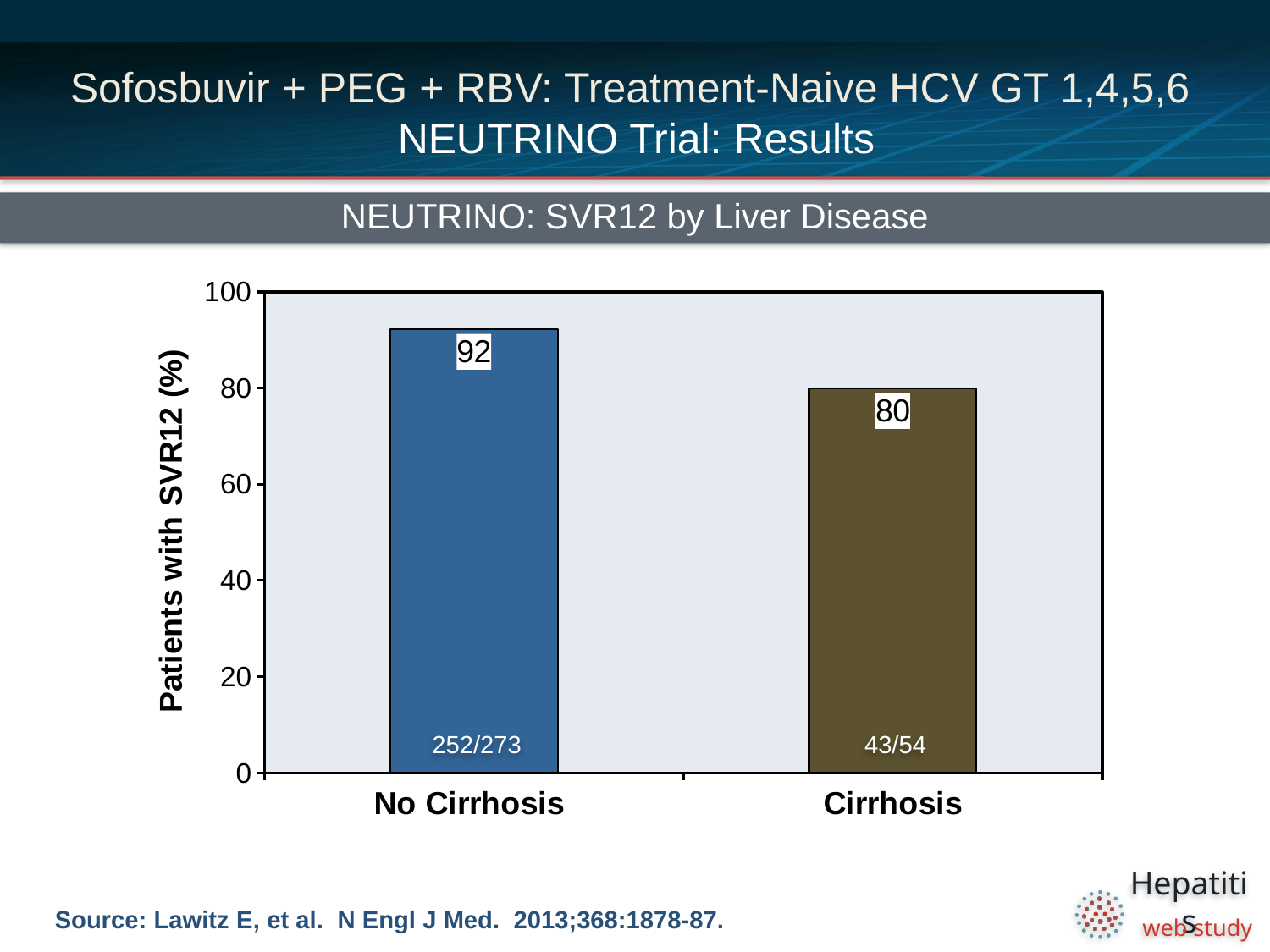
What is the difference in SVR12 rate between the No Cirrhosis and Cirrhosis groups? 12 What fraction of patients is printed inside the No Cirrhosis bar? 252/273 What is the SVR12 rate for the Cirrhosis group? 80 Which group has the higher SVR12 rate? No Cirrhosis Which group has the lower SVR12 rate? Cirrhosis What is the SVR12 rate for the No Cirrhosis group? 92 What kind of chart is shown on the slide? Bar chart What is the title of the chart? NEUTRINO: SVR12 by Liver Disease Is the SVR12 rate for the Cirrhosis group greater or less than 90? less What is the label of the y axis? Patients with SVR12 (%) What fraction of patients is printed inside the Cirrhosis bar? 43/54 How many categories are shown on the x axis? 2